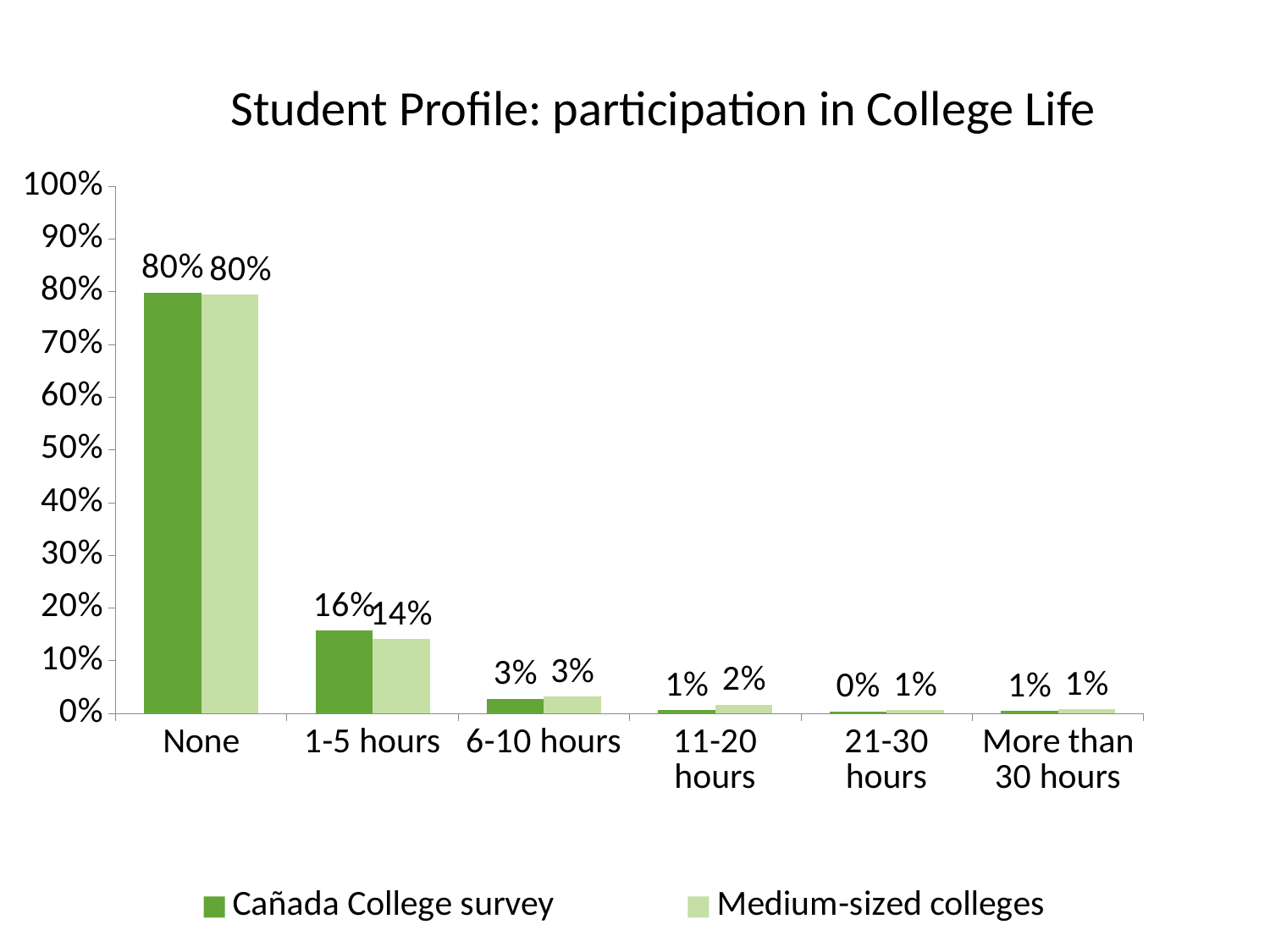
What is the Cañada College survey value for None? 80% For 1-5 hours, which series has the larger value: Cañada College survey or Medium-sized colleges? Cañada College survey What is the title of the chart? Student Profile: participation in College Life What is the difference between the Cañada College survey and Medium-sized colleges values for 1-5 hours? 2% How many categories are shown on the x axis? 6 What is the Cañada College survey value for 1-5 hours? 16% What is the Medium-sized colleges value for 1-5 hours? 14% Which category has the highest value for the Cañada College survey series? None What is the Cañada College survey value for 21-30 hours? 0% What kind of chart is shown on the slide? Bar chart How many series does the legend list? 2 What is the Medium-sized colleges value for 11-20 hours? 2%